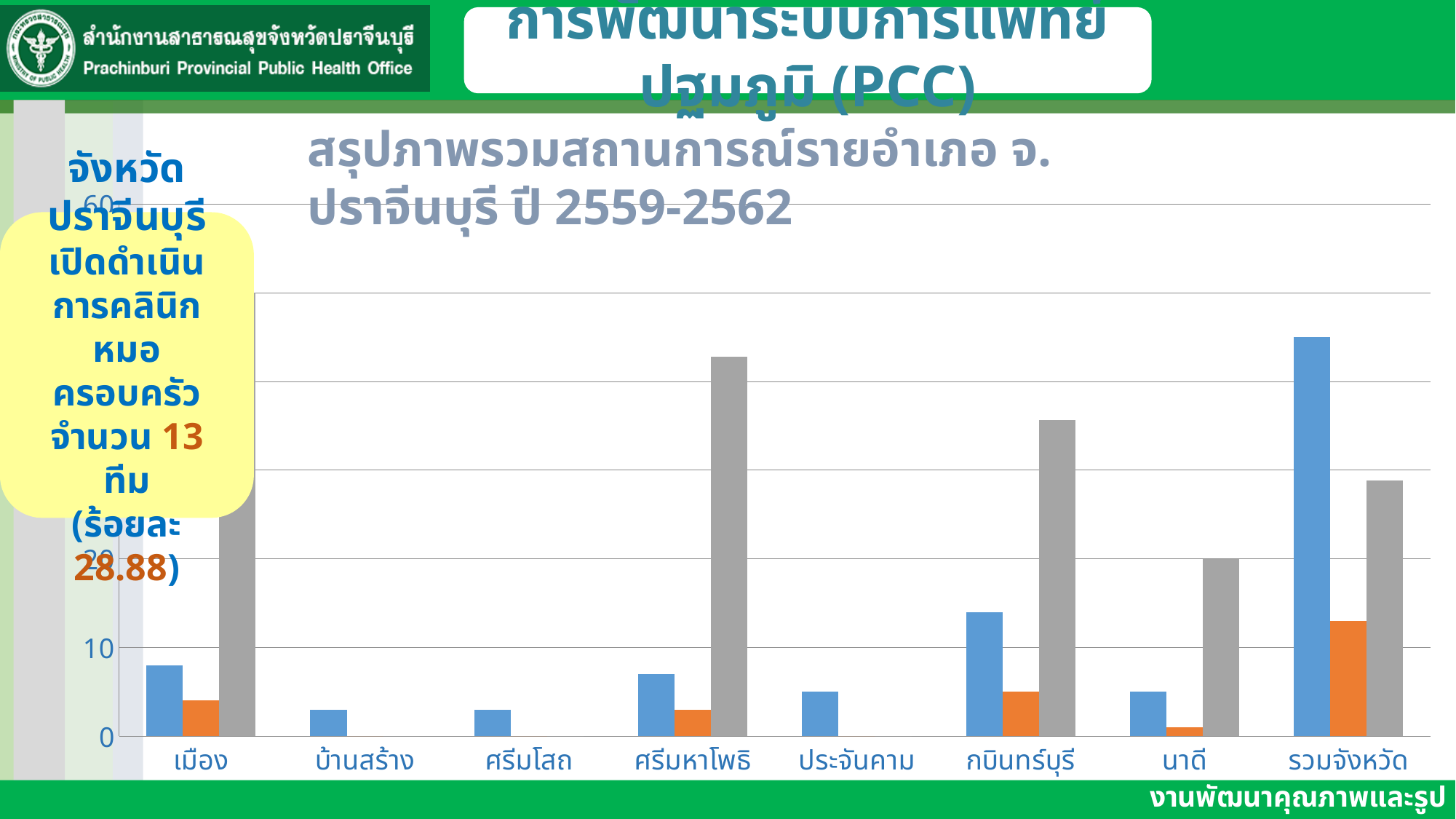
How many categories are shown along the x axis of the chart? 8 Is the value of the blue bar for กบินทร์บุรี greater or less than 10? greater How many bars are plotted for the category รวมจังหวัด? 3 Is the value of the blue bar for รวมจังหวัด greater or less than 40? greater Which category has the tallest blue bar? รวมจังหวัด Which has the larger blue bar, กบินทร์บุรี or เมือง? กบินทร์บุรี Is the value of the orange bar for นาดี greater or less than 10? less What type of chart is shown on the slide? bar chart